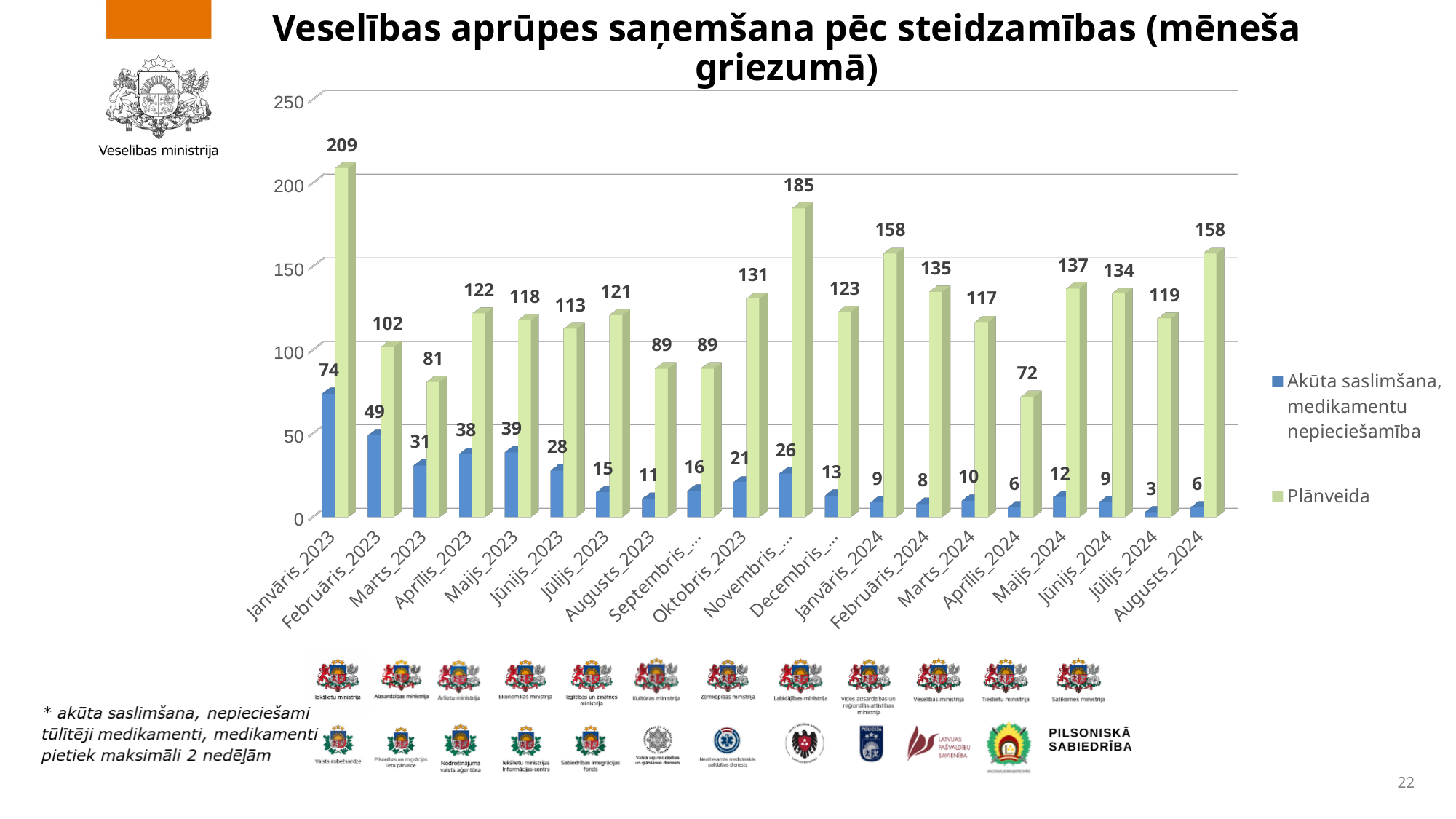
Does the Akūta saslimšana, medikamentu nepieciešamība series generally rise or fall from Janvāris_2023 to Augusts_2024? fall Which month has the highest Plānveida value? Janvāris_2023 Which is larger, the Plānveida value for Februāris_2024 or for Jūnijs_2024? Februāris_2024 What is the Akūta saslimšana, medikamentu nepieciešamība value for Marts_2024? 10 What is the Plānveida value for Janvāris_2023? 209 What is the difference between the Plānveida values for Novembris and Oktobris_2023? 54 Is the Plānveida value for Maijs_2024 greater or less than 100? greater How many months are shown on the x axis? 20 Which month has the lowest Akūta saslimšana, medikamentu nepieciešamība value? Jūlijs_2024 What kind of chart is shown on the slide? bar chart How many series does the legend list? 2 What is the Plānveida value for Aprīlis_2024? 72